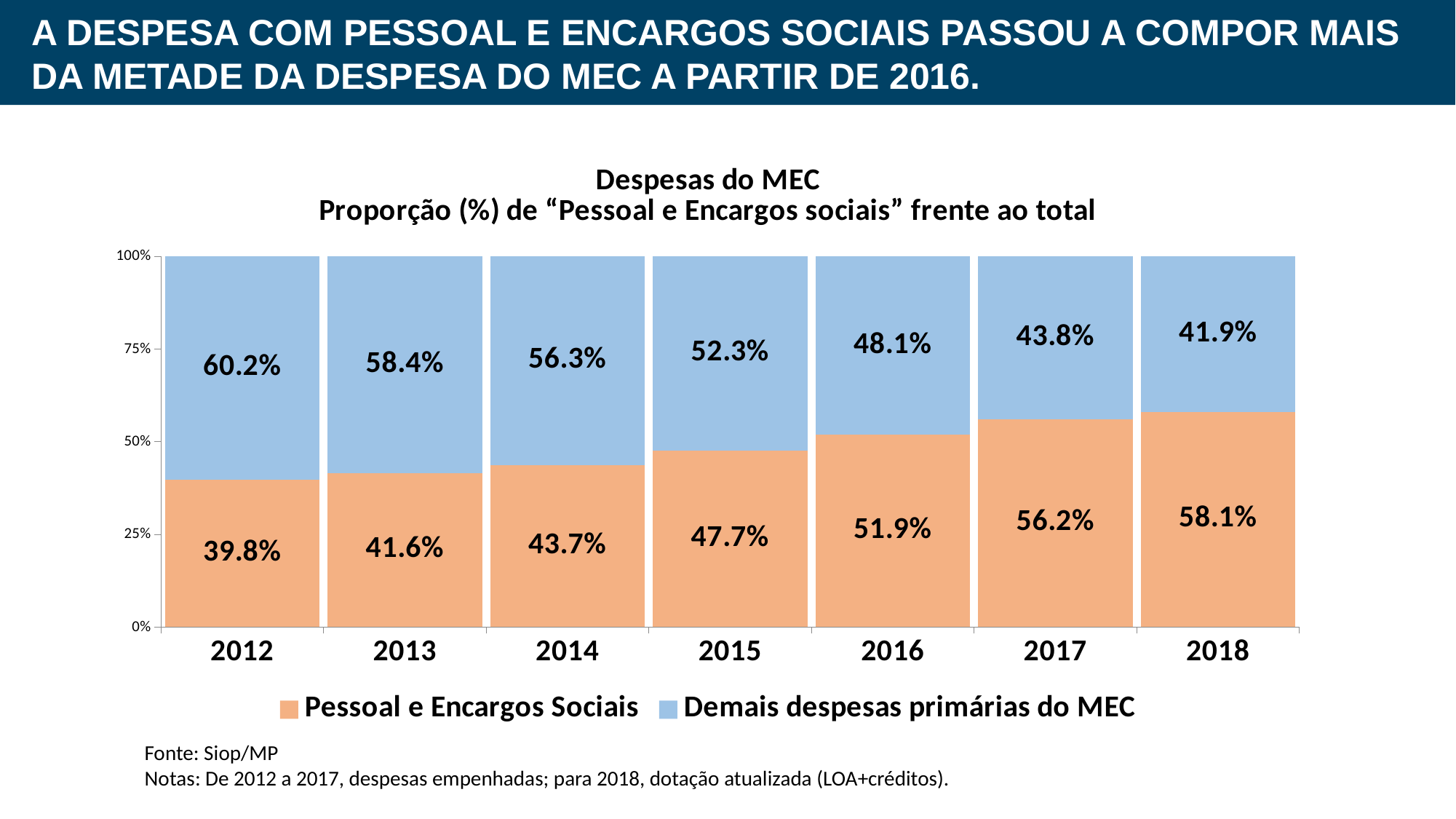
Does the share of Pessoal e Encargos Sociais rise or fall from 2012 to 2018? Rise What is the value for Pessoal e Encargos Sociais in 2018? 58.1% What is the total of the stacked bar for 2017? 100% What is the value for Pessoal e Encargos Sociais in 2016? 51.9% How many series does the legend list? 2 In which year is the share of Pessoal e Encargos Sociais highest? 2018 What kind of chart is shown? Stacked bar chart What is the difference between the Pessoal e Encargos Sociais share in 2018 and in 2012? 18.3 percentage points Which is larger in 2015: Pessoal e Encargos Sociais or Demais despesas primárias do MEC? Demais despesas primárias do MEC What is the value for Demais despesas primárias do MEC in 2012? 60.2% How many years are shown on the x axis? 7 In which year is the share of Pessoal e Encargos Sociais lowest? 2012